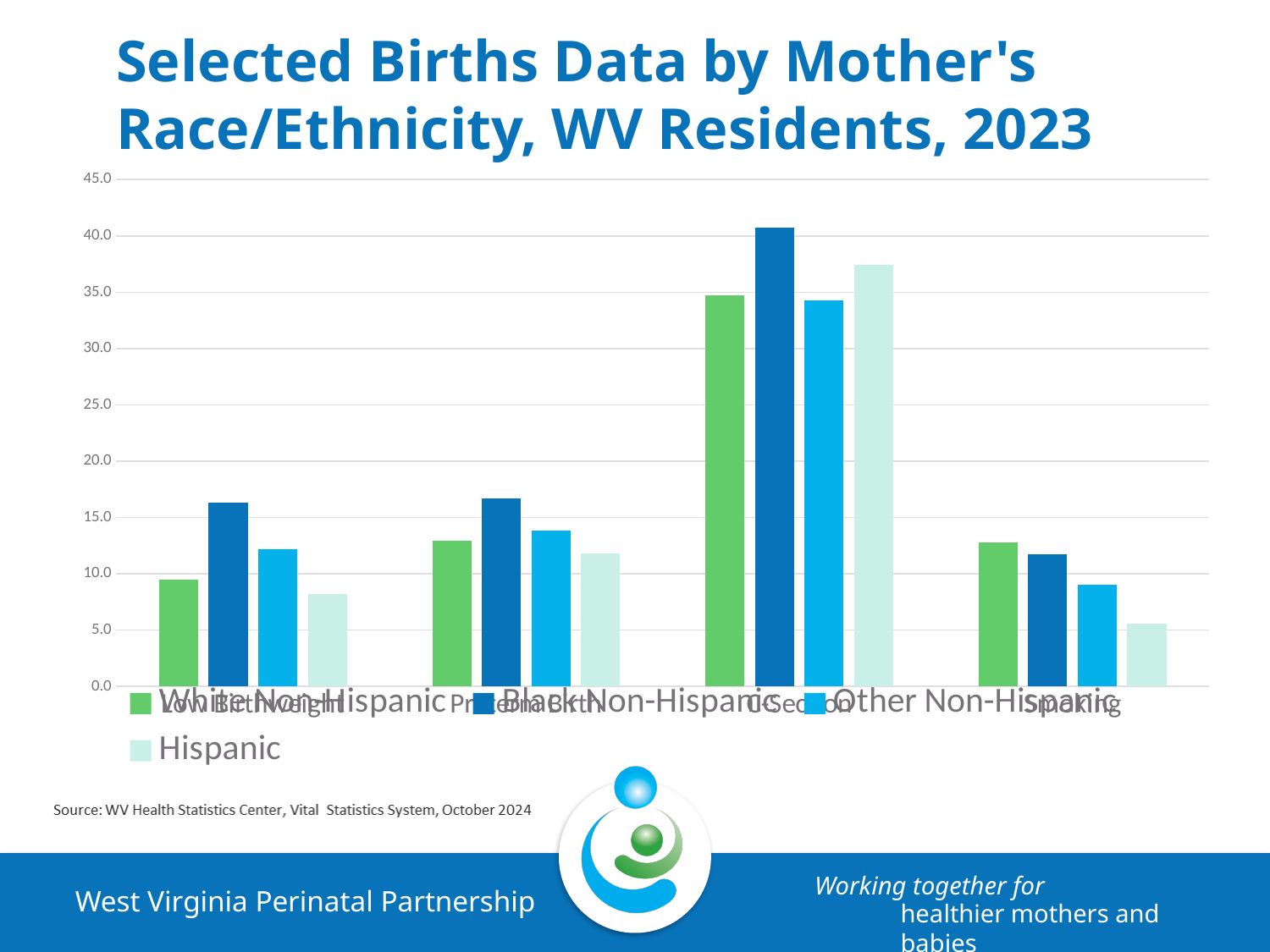
How many category groups of bars are plotted along the x axis? 4 What kind of chart is shown on the slide? bar chart Is the Black Non-Hispanic value in the third (C-Section) group greater or less than 35? greater In the fourth (Smoking) group, do the bars rise or fall from left to right? fall Is the Hispanic value in the fourth (Smoking) group greater or less than 10? less Which category group has the highest values overall? C-Section (third group) In the first group, is the Black Non-Hispanic bar or the White Non-Hispanic bar taller? Black Non-Hispanic Which series has the tallest bar in the third (C-Section) group? Black Non-Hispanic In the fourth (Smoking) group, is the White Non-Hispanic bar or the Hispanic bar taller? White Non-Hispanic How many series does the legend list? 4 What is the title of the chart slide? Selected Births Data by Mother's Race/Ethnicity, WV Residents, 2023 Which series has the shortest bar in the fourth (Smoking) group? Hispanic